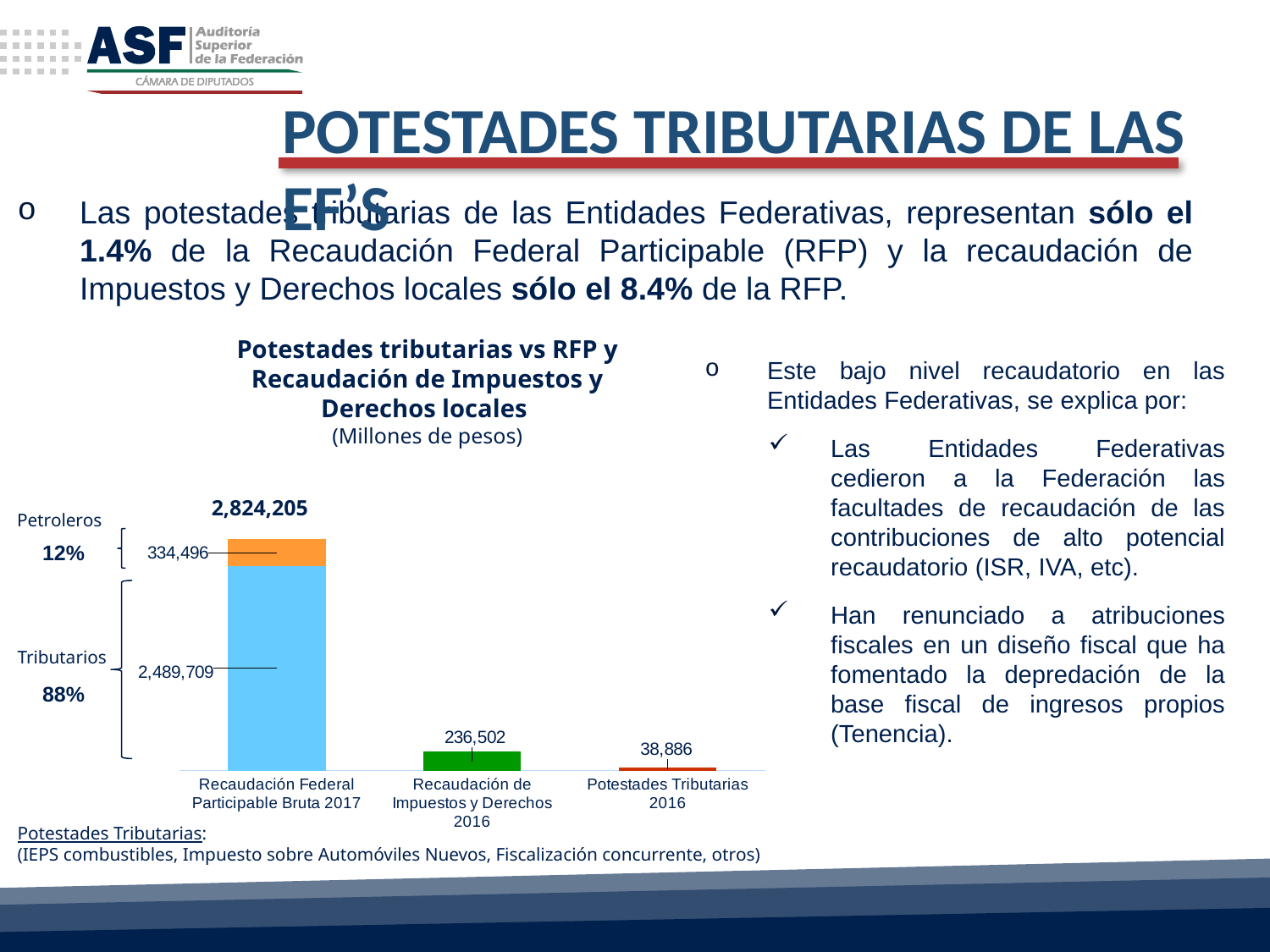
Which category has the highest total value in the chart? Recaudación Federal Participable Bruta 2017 What is the value shown for Recaudación de Impuestos y Derechos 2016? 236,502 What percentage share does the Tributarios segment represent according to the bracket label on the chart? 88% What is the value of the Petroleros segment in the Recaudación Federal Participable Bruta 2017 bar? 334,496 What is the total value shown for Recaudación Federal Participable Bruta 2017? 2,824,205 Which is larger: Recaudación de Impuestos y Derechos 2016 or Potestades Tributarias 2016? Recaudación de Impuestos y Derechos 2016 Which category has the lowest value in the chart? Potestades Tributarias 2016 What type of chart is shown on the slide? Bar chart How many categories are shown on the x axis of the chart? 3 What is the value shown for Potestades Tributarias 2016? 38,886 What is the value of the Tributarios segment in the Recaudación Federal Participable Bruta 2017 bar? 2,489,709 What is the difference between Recaudación de Impuestos y Derechos 2016 and Potestades Tributarias 2016? 197,616